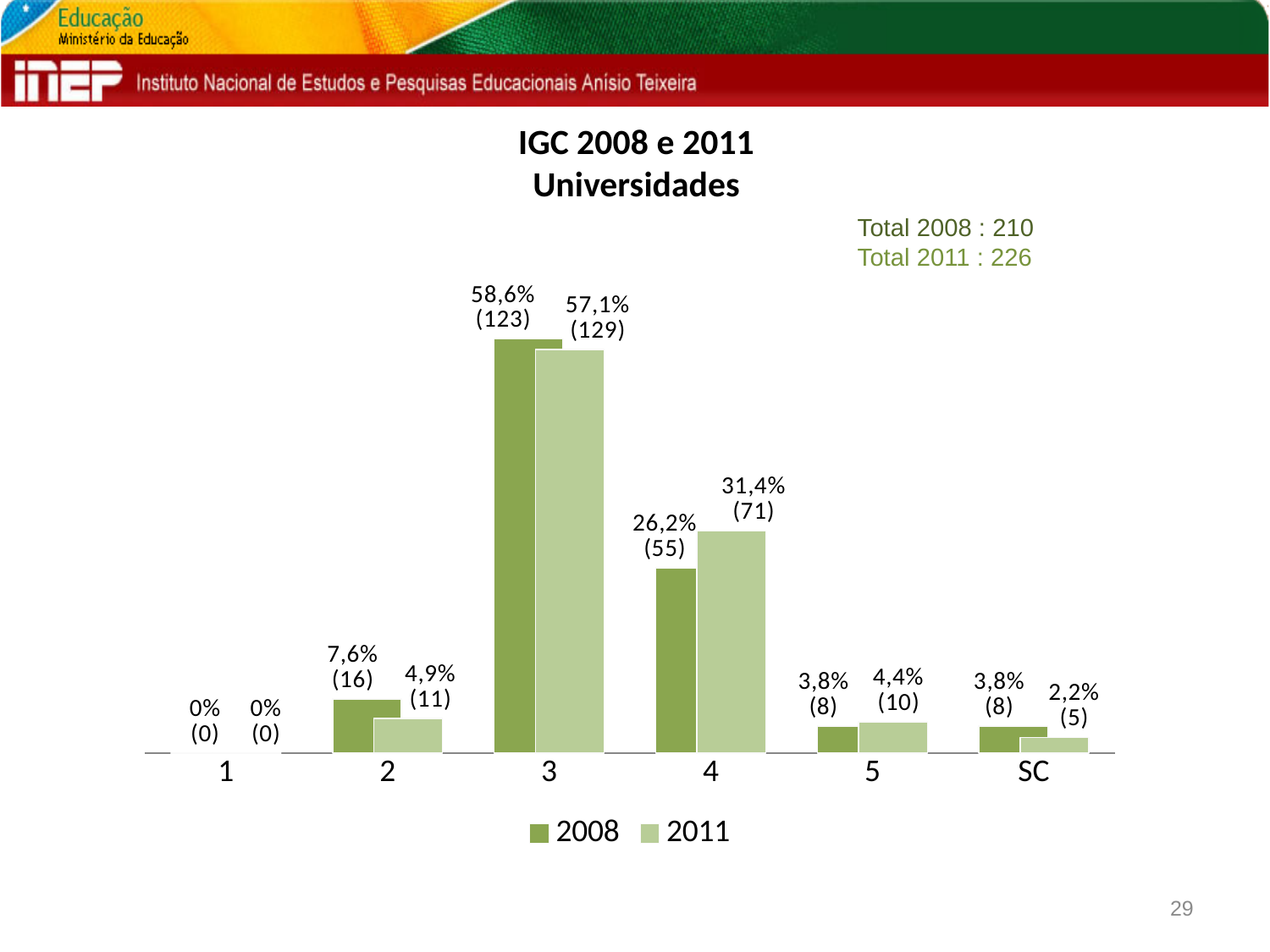
What is the 2008 value for category 2? 7,6% (16) What is the 2008 value for category 3? 58,6% (123) How many series does the legend list? 2 What is the 2011 value for category SC? 2,2% (5) What is the 2011 value for category 4? 31,4% (71) How many categories are shown on the x axis? 6 Which category has the highest 2011 value? 3 What kind of chart is shown? bar chart What is the total for 2011 stated on the slide? 226 What is the difference in count between 2011 and 2008 for category 4? 16 Which category has the lowest 2008 value? 1 For category 5, which year has the larger value, 2008 or 2011? 2011